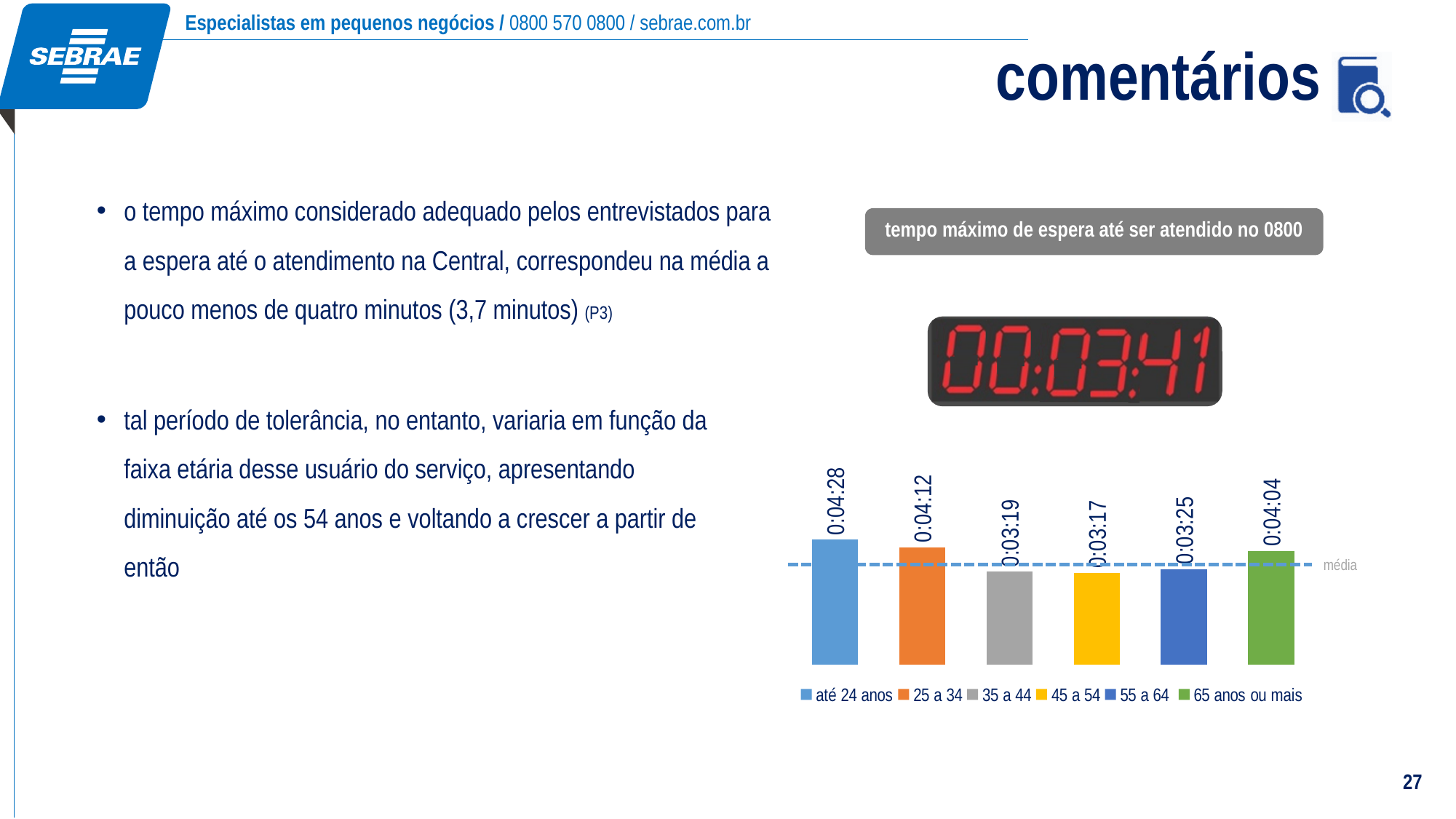
How many entries does the chart legend list? 6 What is the value shown for the '65 anos ou mais' bar? 0:04:04 Which age group has the highest value in the chart? até 24 anos Which age group has the lowest value in the chart? 45 a 54 What does the dashed horizontal line across the chart represent? média What is the title shown above the chart? tempo máximo de espera até ser atendido no 0800 What is the value shown for the '45 a 54' bar? 0:03:17 What is the value shown for the 'até 24 anos' bar? 0:04:28 Which is larger, the value for '25 a 34' or the value for '35 a 44'? 25 a 34 What is the value shown for the '55 a 64' bar? 0:03:25 What kind of chart is shown on the slide? bar chart How many bars are plotted in the chart? 6